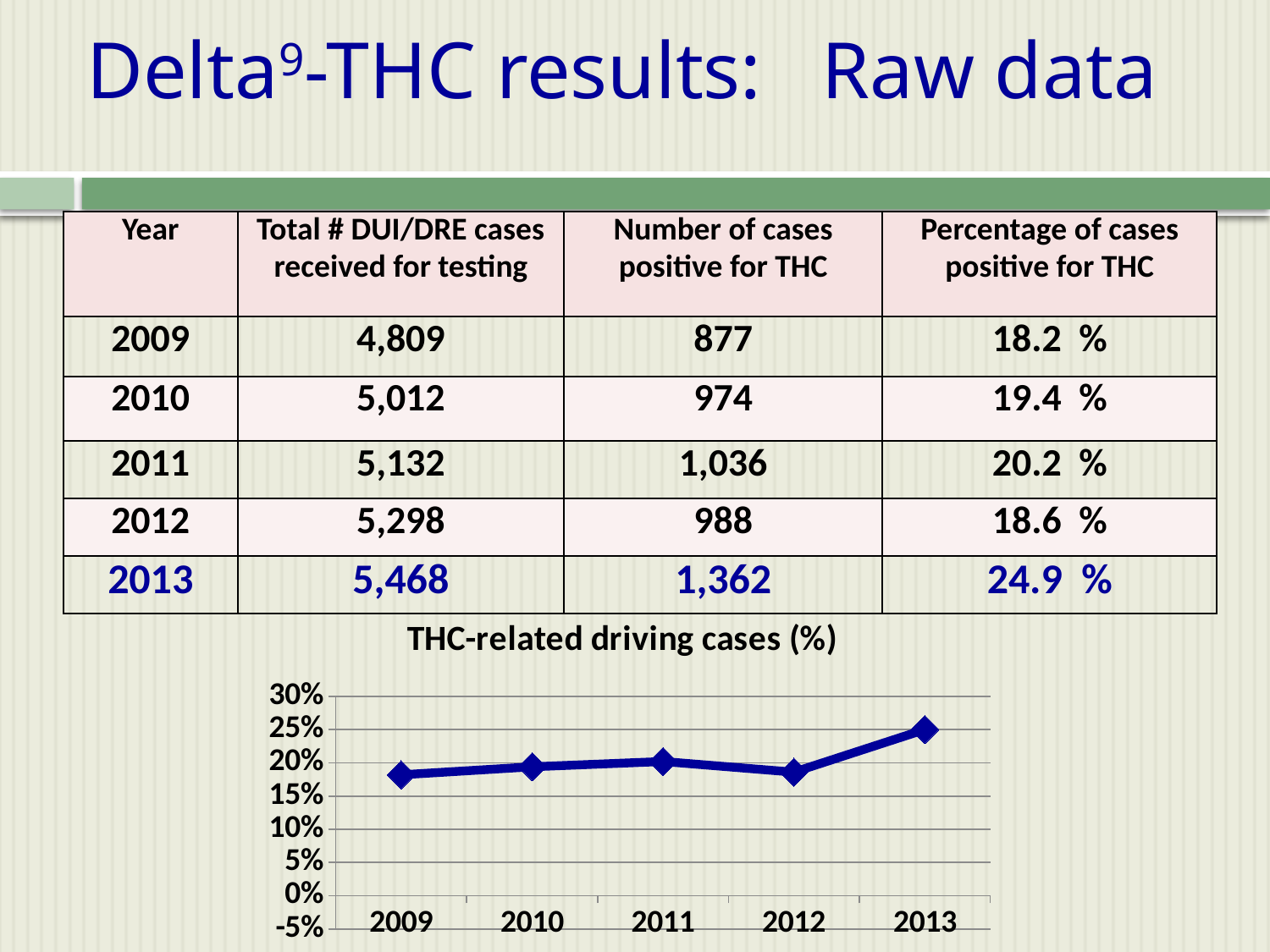
Is the value for 2009 greater or less than 20%? less How many years are plotted on the chart? 5 Which is larger on the chart, the value for 2012 or the value for 2013? 2013 Is the value for 2013 greater or less than 30%? less Is the value for 2011 greater or less than 15%? greater What kind of chart is shown on the slide? line chart Which year has the highest value on the chart? 2013 What is the title of the chart? THC-related driving cases (%) What is the lowest value shown on the chart's vertical axis? -5% Which year has the lowest value on the chart? 2009 Does the line rise or fall between 2012 and 2013? rise